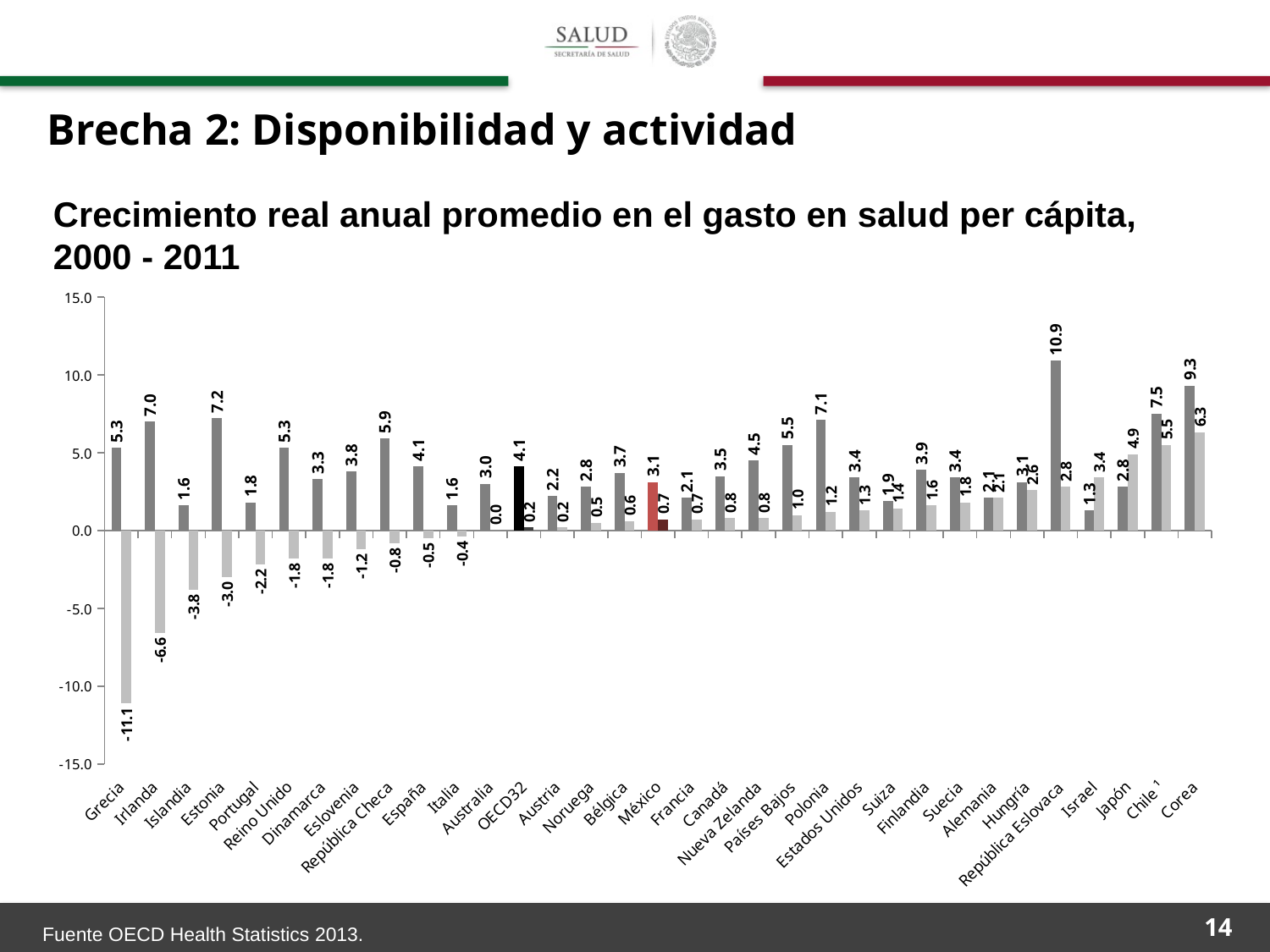
What type of chart is shown on the slide? bar chart What is the value of the light bar for Corea? 6.3 What is the value of the light bar for Grecia? -11.1 Which country has the highest dark bar value? República Eslovaca Which is larger, the dark bar value for Irlanda or for Estonia? Estonia What is the value of the dark bar for OECD32? 4.1 Which bar is highlighted in red on the chart? México What is the value of the dark bar for México? 3.1 Is the dark bar value for República Eslovaca greater or less than 10.0? greater Which country has the lowest light bar value? Grecia What is the difference between the dark bar values of Corea and Chile? 1.8 How many countries or groups are shown on the x axis? 33